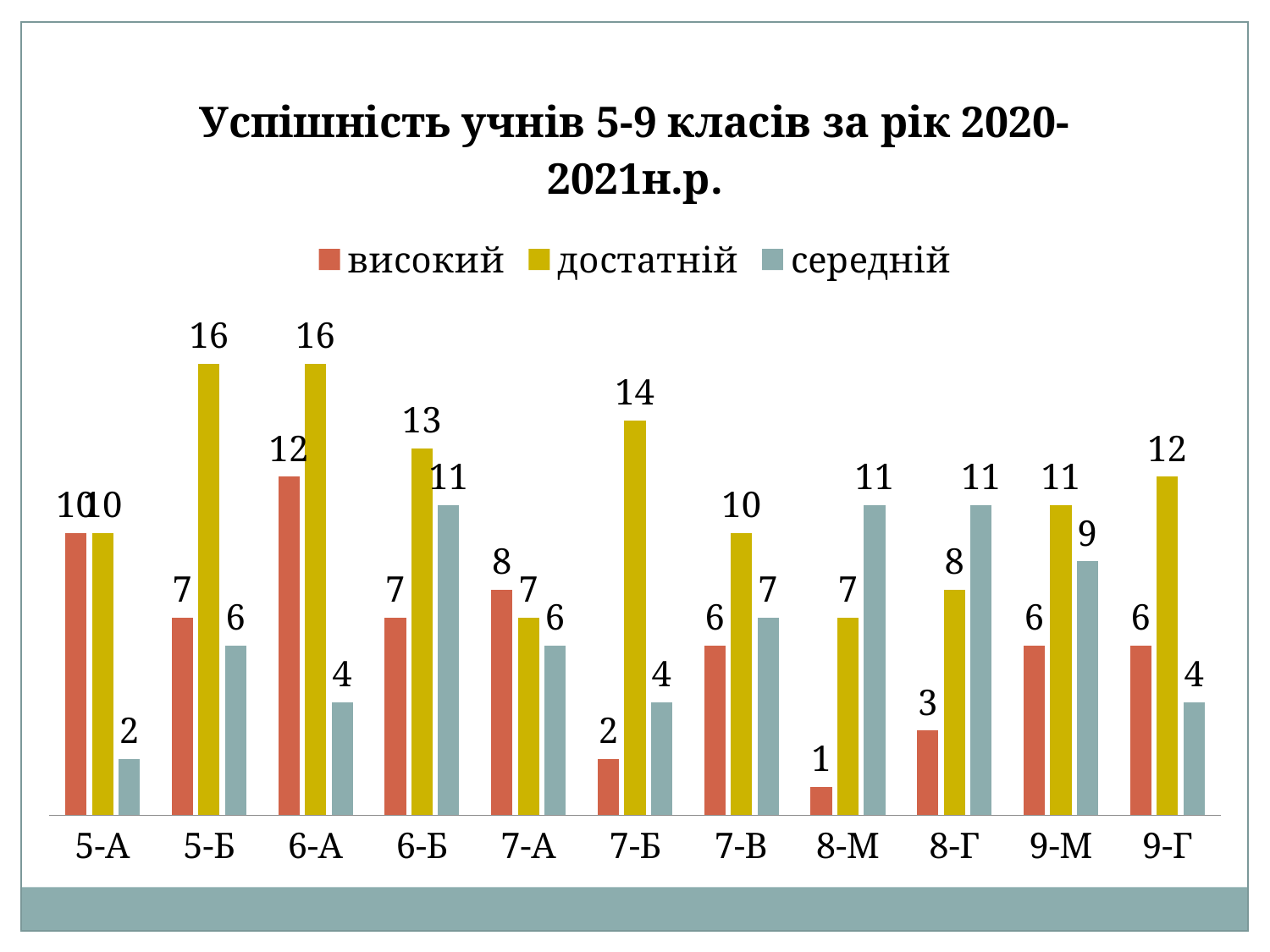
How many series does the legend list? 3 For class 9-Г, what is the difference between the достатній value and the середній value? 8 Which class has the highest value in the високий series? 6-А How many classes are shown on the x axis? 11 Which class has the lowest value in the високий series? 8-М For class 7-Б, what is the difference between the достатній value and the високий value? 12 What is the value of the достатній series for class 7-Б? 14 Which class has the lowest value in the середній series? 5-А What is the value of the високий series for class 6-А? 12 What kind of chart is shown on the slide? Bar chart Which class has a larger середній value, 6-Б or 9-М? 6-Б What is the value of the середній series for class 8-М? 11